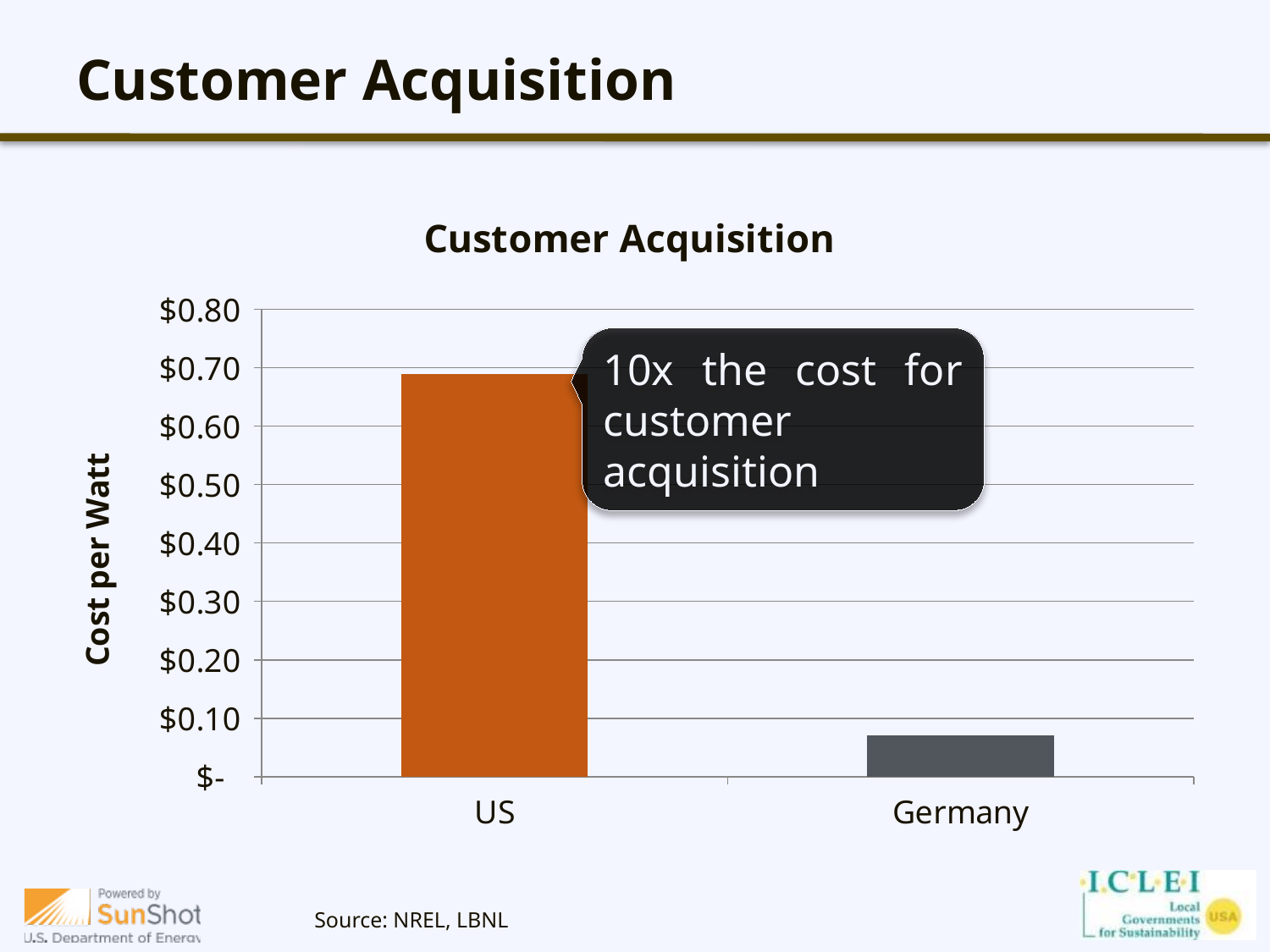
Is the cost per Watt for Germany greater or less than $0.10? less Which has a larger cost per Watt, the US or Germany? US Which category has the highest cost per Watt? US What is the label of the vertical axis? Cost per Watt What type of chart is shown on the slide? bar chart What is the highest value shown on the vertical axis? $0.80 How many categories are shown on the x axis of the chart? 2 What is the title of the chart? Customer Acquisition Is the cost per Watt for the US greater or less than $0.60? greater Which category has the lowest cost per Watt? Germany